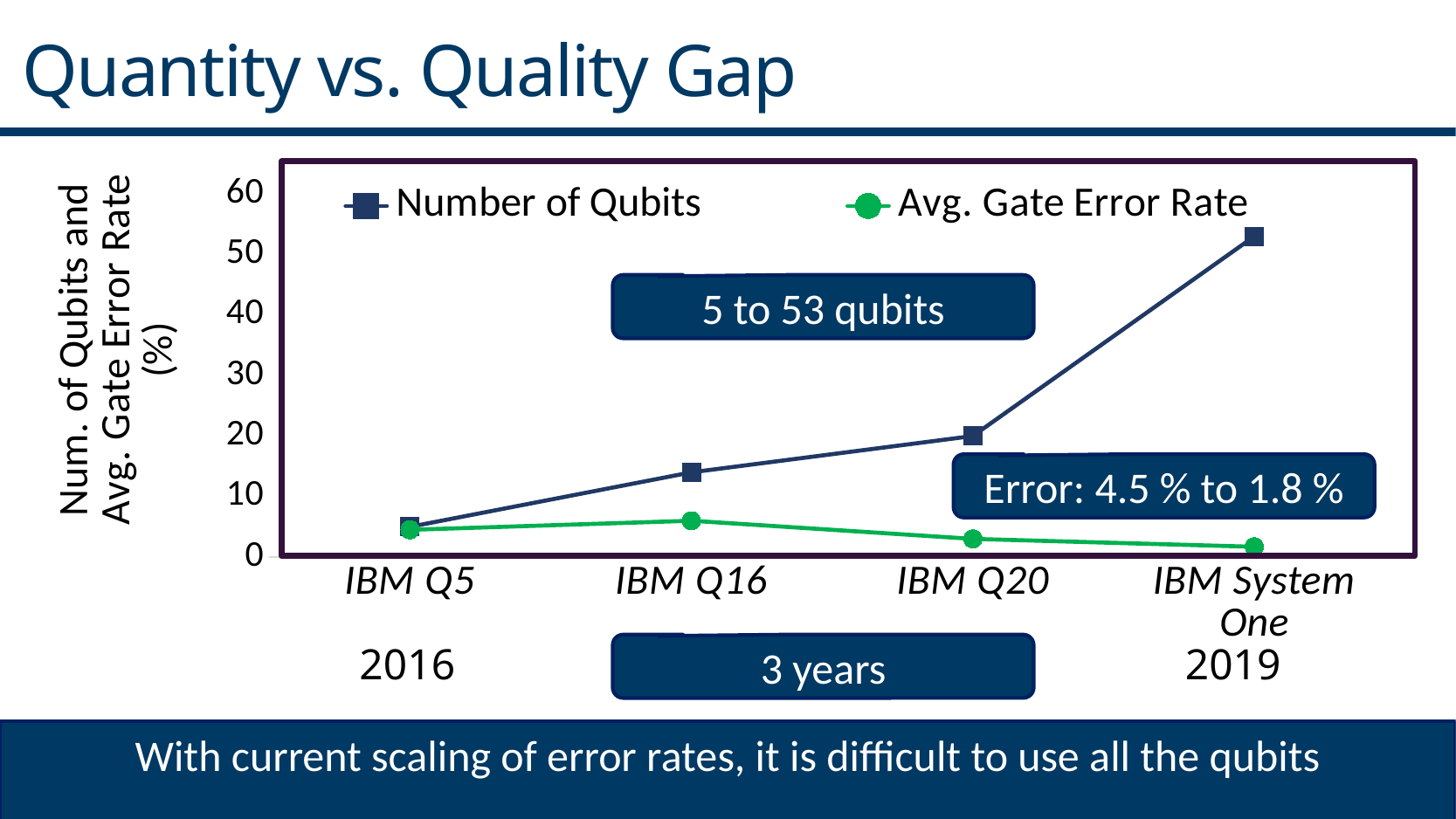
How many series does the legend list? 2 Is the Avg. Gate Error Rate for IBM Q16 greater or less than 10? less Is the Number of Qubits for IBM System One greater or less than 50? greater Which system has the highest Avg. Gate Error Rate? IBM Q16 Which is larger, the Number of Qubits for IBM Q20 or for IBM Q16? IBM Q20 Is the Number of Qubits for IBM Q20 greater or less than 10? greater According to the annotation, what is the Avg. Gate Error Rate for IBM System One? 1.8 % How many systems are plotted along the x axis? 4 What kind of chart is shown on the slide? line chart Does the Number of Qubits rise or fall from IBM Q5 to IBM System One? rise Which system has the highest Number of Qubits? IBM System One Which system has the lowest Number of Qubits? IBM Q5